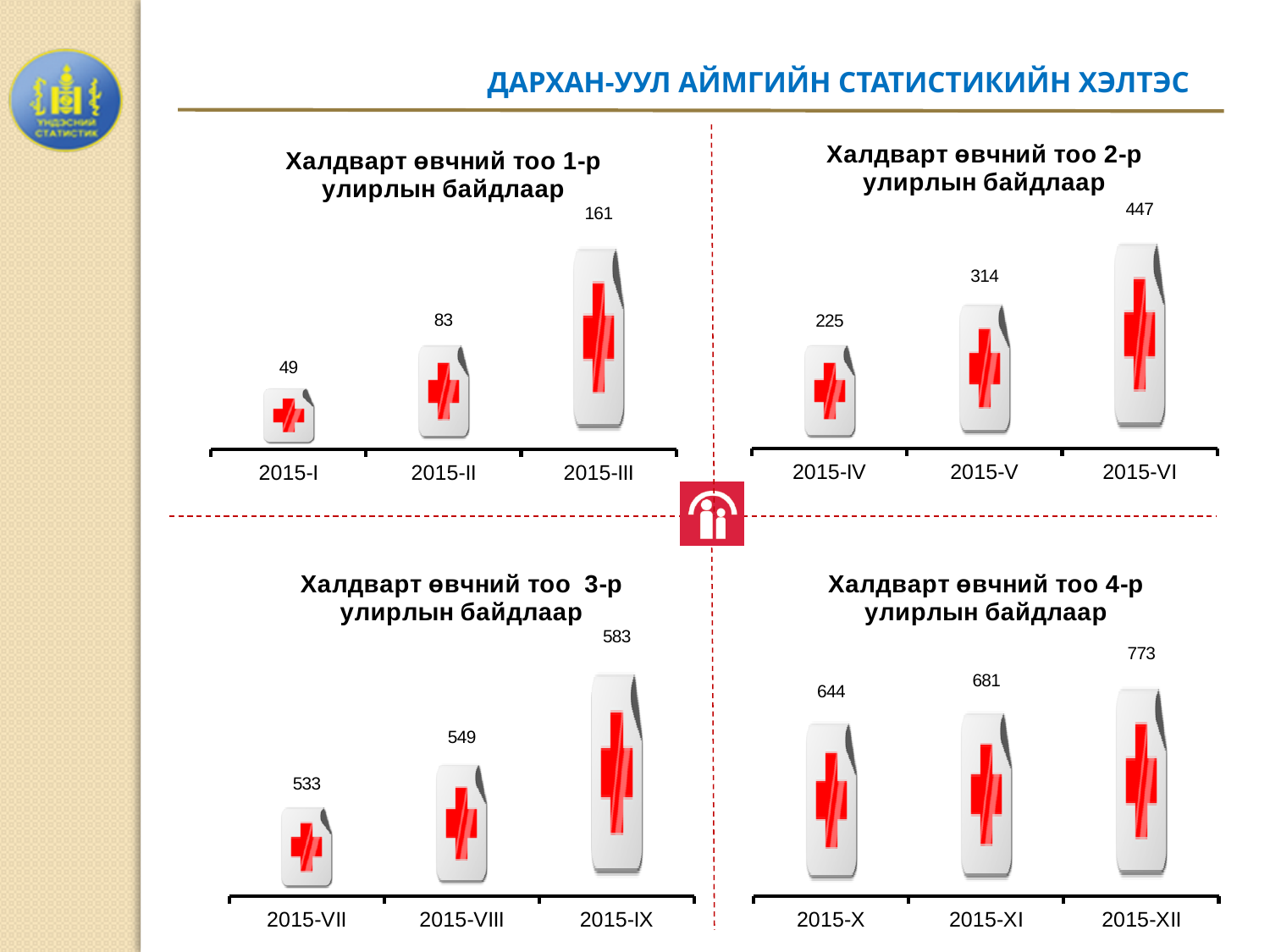
In the bottom-left chart (Халдварт өвчний тоо 3-р улирлын байдлаар), what is the difference between the values for 2015-VIII and 2015-VII? 16 In the top-right chart (Халдварт өвчний тоо 2-р улирлын байдлаар), do the values rise or fall from 2015-IV to 2015-VI? rise How many categories are shown in the bottom-right chart (Халдварт өвчний тоо 4-р улирлын байдлаар)? 3 In the top-left chart (Халдварт өвчний тоо 1-р улирлын байдлаар), what is the value for 2015-II? 83 In the top-left chart (Халдварт өвчний тоо 1-р улирлын байдлаар), which category has the highest value? 2015-III In the top-right chart (Халдварт өвчний тоо 2-р улирлын байдлаар), what is the value for 2015-V? 314 In the bottom-right chart (Халдварт өвчний тоо 4-р улирлын байдлаар), which is larger, the value for 2015-XI or 2015-XII? 2015-XII What kind of chart is the top-left chart (Халдварт өвчний тоо 1-р улирлын байдлаар)? bar chart In the bottom-right chart (Халдварт өвчний тоо 4-р улирлын байдлаар), what is the value for 2015-X? 644 In the top-right chart (Халдварт өвчний тоо 2-р улирлын байдлаар), which category has the lowest value? 2015-IV In the top-left chart (Халдварт өвчний тоо 1-р улирлын байдлаар), what is the difference between the values for 2015-III and 2015-I? 112 In the bottom-left chart (Халдварт өвчний тоо 3-р улирлын байдлаар), what is the value for 2015-IX? 583